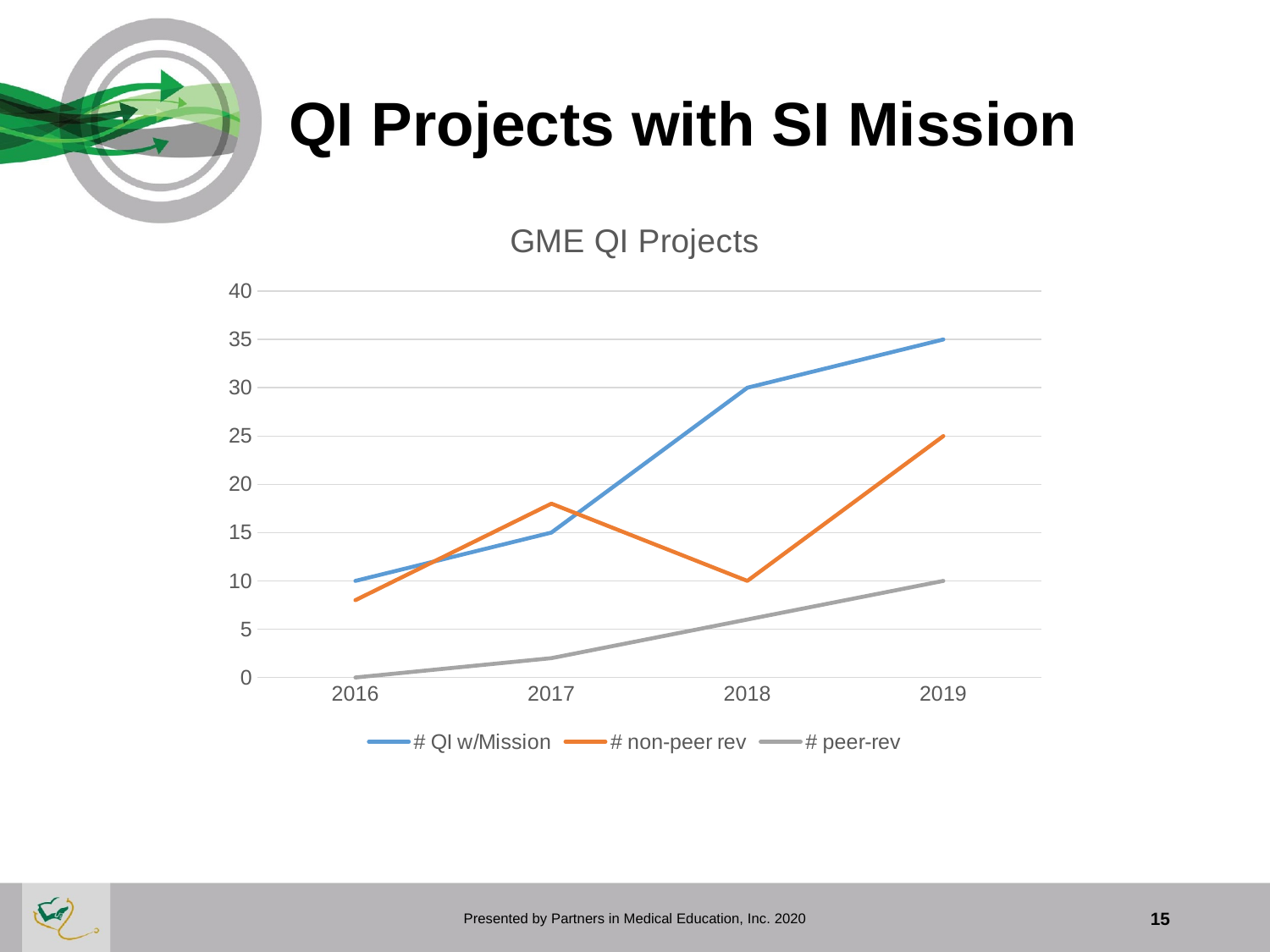
Which is larger in 2018, # QI w/Mission or # non-peer rev? # QI w/Mission In which year is # QI w/Mission highest? 2019 What is the value of # QI w/Mission in 2019? 35 What is the difference between # QI w/Mission in 2019 and in 2016? 25 How many years are shown on the x axis? 4 Does # QI w/Mission rise or fall from 2016 to 2019? Rise What is the title of the chart? GME QI Projects How many series does the legend list? 3 Is the value of # non-peer rev in 2017 greater or less than 15? greater What type of chart is shown on the slide? Line chart What is the value of # peer-rev in 2016? 0 What is the value of # non-peer rev in 2019? 25